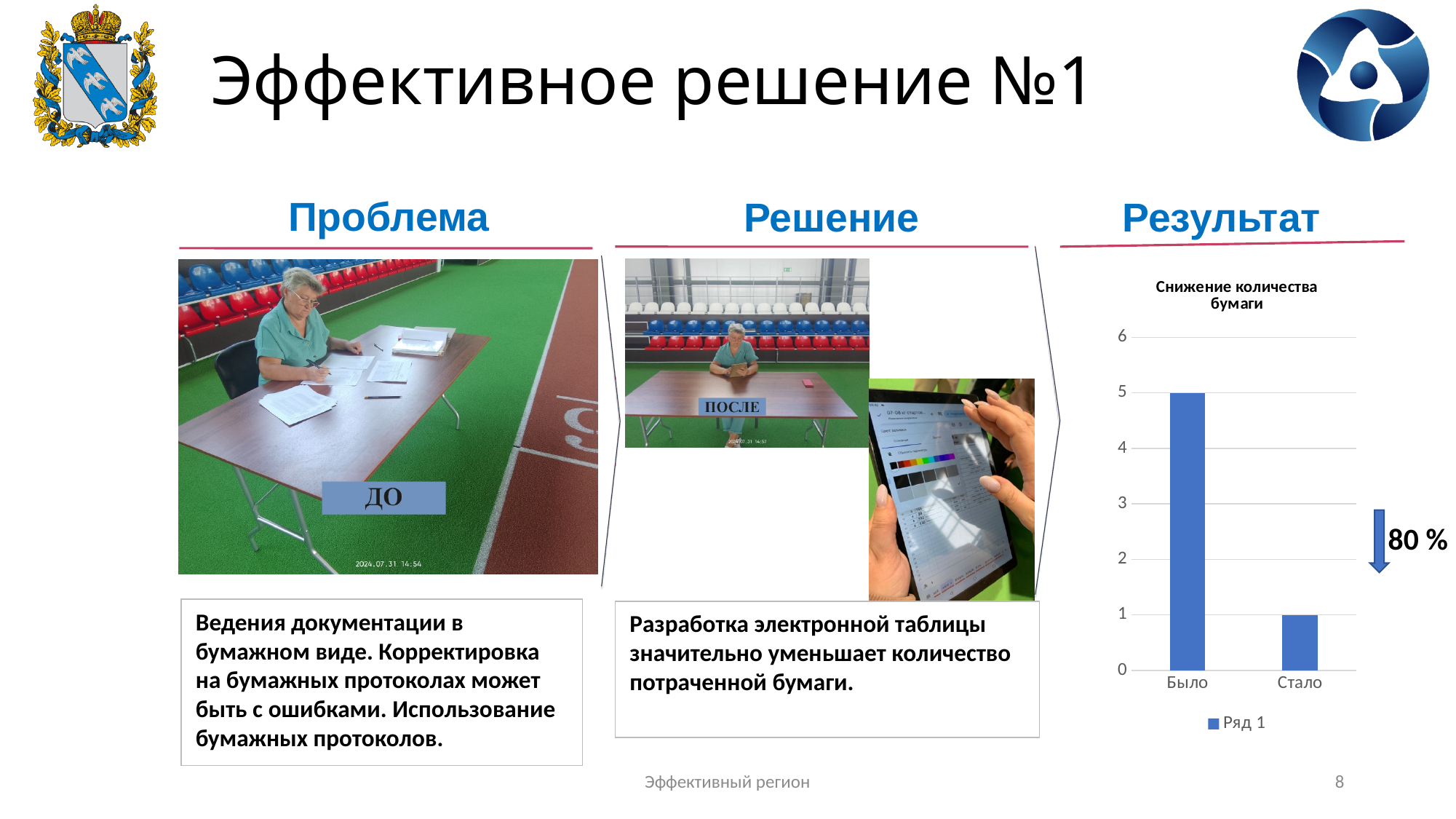
Is the value for "Было" greater or less than 3? greater How many categories are shown on the x axis of the chart? 2 What is the difference between the values for "Было" and "Стало"? 4 Which is larger, the value for "Было" or the value for "Стало"? Было What is the title of the chart on the slide? Снижение количества бумаги What is the name of the series in the chart legend? Ряд 1 Which category has the lowest value in the chart? Стало How many series does the chart legend list? 1 What is the value for "Стало" in the chart? 1 Which category has the highest value in the chart? Было What is the value for "Было" in the chart? 5 What type of chart is shown under "Результат"? bar chart